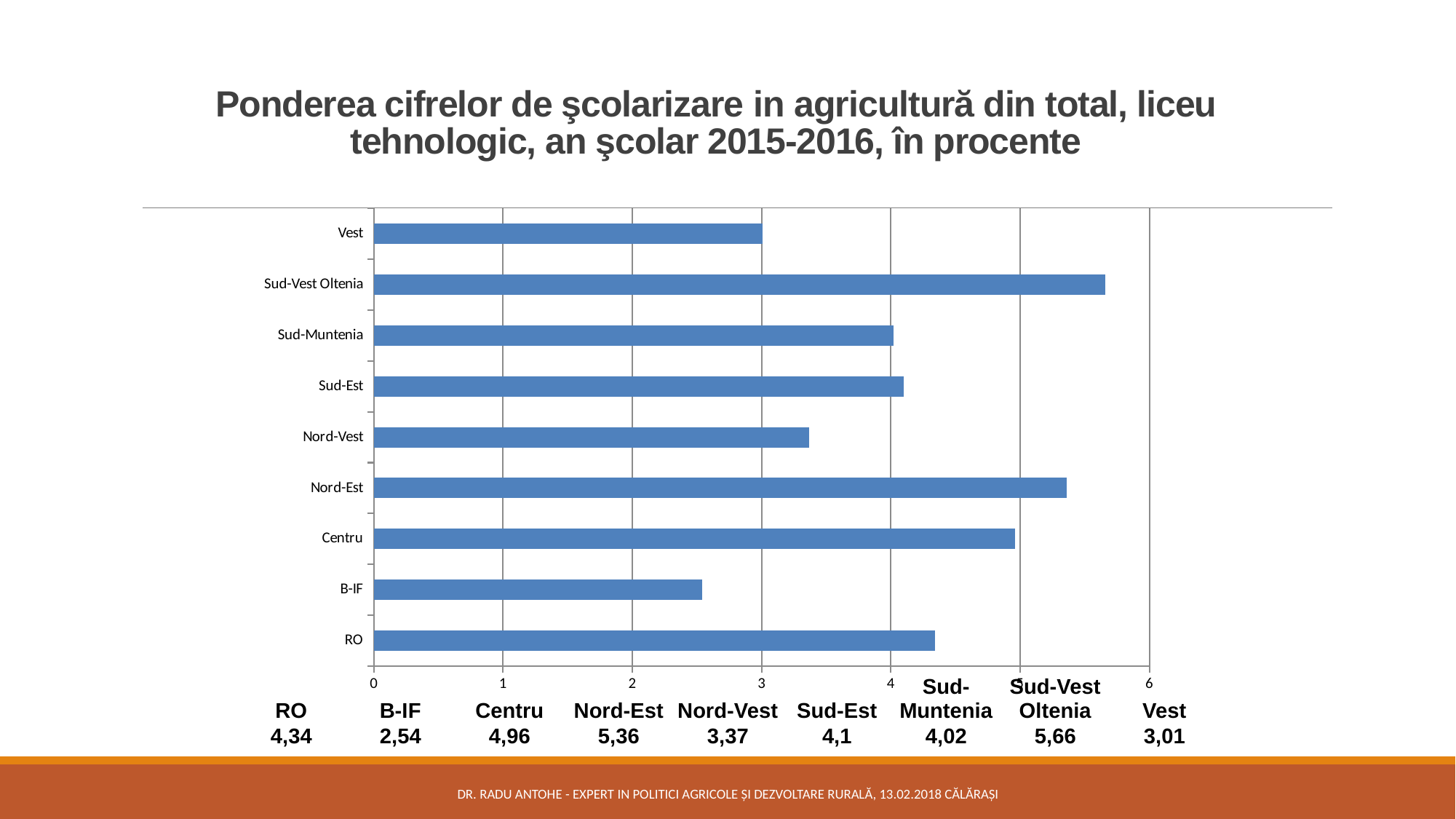
What is the value for B-IF? 2,54 Which is larger, the value for Centru or the value for Nord-Vest? Centru Which region has the highest value? Sud-Vest Oltenia How many categories are shown in the chart? 9 Which category has the lowest value? B-IF What is the value for RO? 4,34 What is the difference between the values for Sud-Vest Oltenia and B-IF? 3,12 What is the value for Nord-Vest? 3,37 What is the difference between the values for Nord-Est and Vest? 2,35 What is the value for Sud-Vest Oltenia? 5,66 Is the value for B-IF greater or less than 3? less What kind of chart is shown on the slide? bar chart